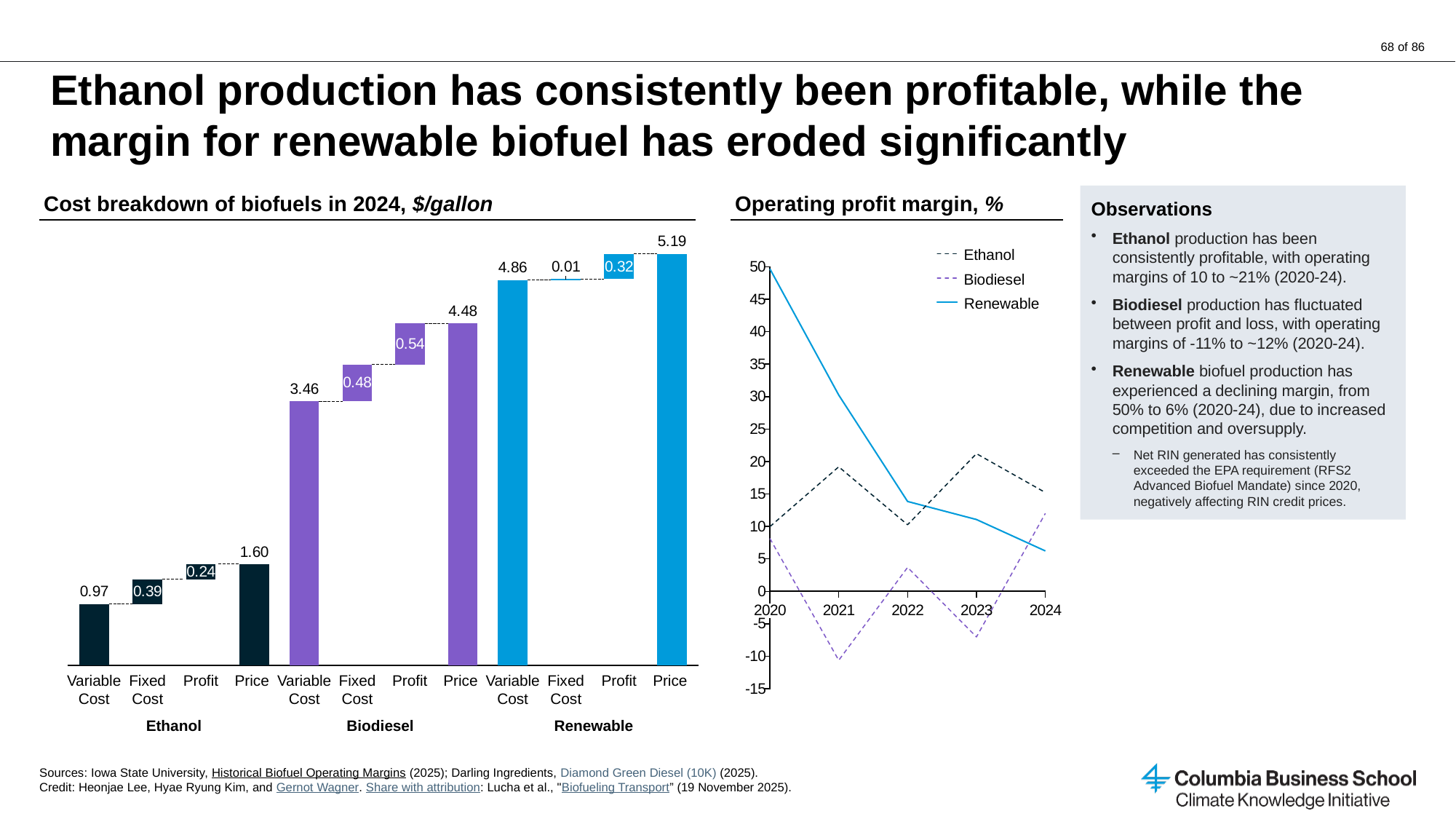
In the 'Operating profit margin, %' chart, how many series does the legend list? 3 In the 'Cost breakdown of biofuels in 2024' chart, what is the difference between the Price of Renewable and the Price of Ethanol? 3.59 In the 'Operating profit margin, %' chart, does the Renewable line rise or fall from 2020 to 2024? fall In the 'Cost breakdown of biofuels in 2024' chart, what is the Variable Cost for Ethanol? 0.97 In the 'Cost breakdown of biofuels in 2024' chart, which fuel has the lowest Variable Cost? Ethanol In the 'Cost breakdown of biofuels in 2024' chart, which fuel has the highest Price? Renewable What kind of chart is the 'Operating profit margin, %' chart? line chart In the 'Cost breakdown of biofuels in 2024' chart, is the Profit for Biodiesel larger or smaller than the Profit for Renewable? larger In the 'Operating profit margin, %' chart, is the Renewable value for 2020 greater or less than 45? greater In the 'Cost breakdown of biofuels in 2024' chart, what is the Fixed Cost for Renewable? 0.01 In the 'Cost breakdown of biofuels in 2024' chart, what is the Profit for Biodiesel? 0.54 In the 'Cost breakdown of biofuels in 2024' chart, what is the Price for Biodiesel? 4.48